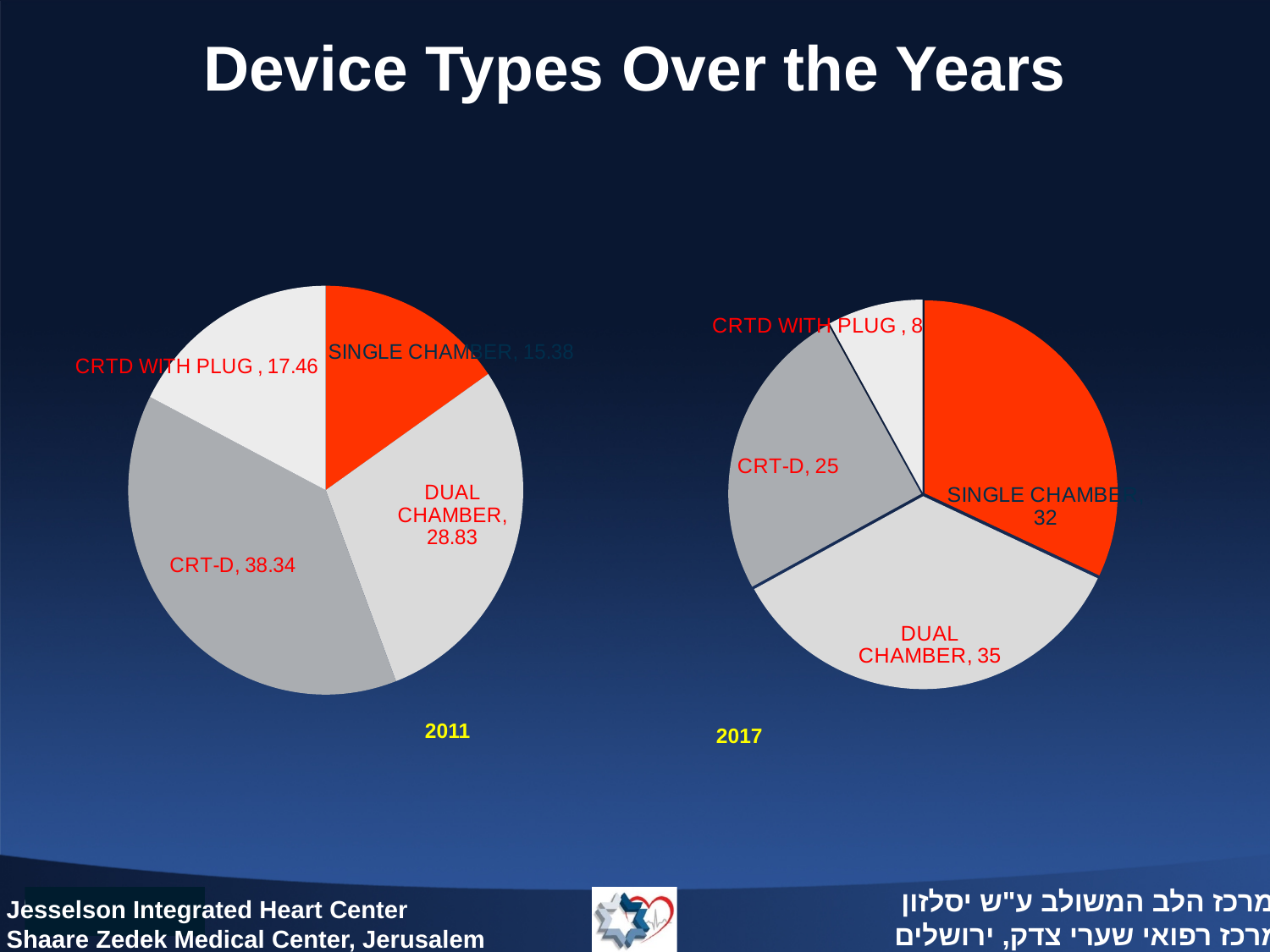
In the 2017 pie chart, what is the value for CRTD WITH PLUG? 8 In the 2011 pie chart, what is the value for DUAL CHAMBER? 28.83 In the 2017 pie chart, which device type has the largest slice? DUAL CHAMBER In the 2017 pie chart, what is the value for SINGLE CHAMBER? 32 In the 2011 pie chart, what is the value for CRTD WITH PLUG? 17.46 In the 2017 pie chart, which device type has the smallest slice? CRTD WITH PLUG In the 2017 pie chart, what is the difference between the DUAL CHAMBER value and the CRT-D value? 10 What type of chart is used for the 2011 data on the slide? Pie chart In the 2011 pie chart, which is larger: CRT-D or DUAL CHAMBER? CRT-D In the 2011 pie chart, which device type has the largest slice? CRT-D How many slices does the 2017 pie chart have? 4 In the 2011 pie chart, what is the value for CRT-D? 38.34